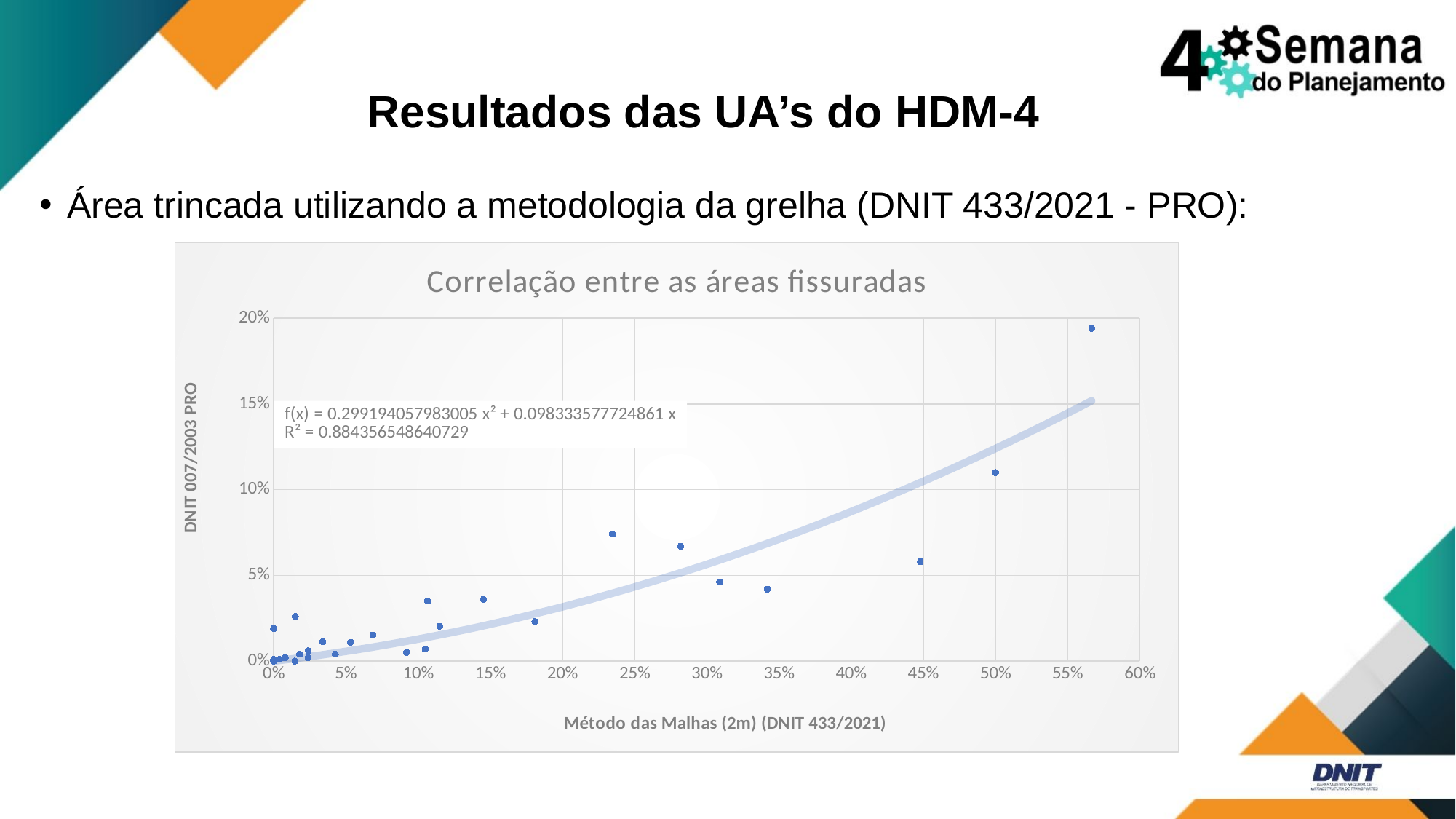
What is the title of the chart? Correlação entre as áreas fissuradas What is the coefficient of x in the trendline equation printed on the chart? 0.098333577724861 Is the y value of the highest plotted point greater or less than 15%? greater Do the plotted values generally rise or fall as the x-axis value increases? Rise What is the highest tick value shown on the y axis? 20% Is the y value of the point plotted at about 50% on the x axis greater or less than 10%? greater What kind of chart is shown on the slide? Scatter chart What R² value is printed on the chart for the trendline? 0.884356548640729 What is the coefficient of x² in the trendline equation printed on the chart? 0.299194057983005 Is the x value of the highest plotted point greater or less than 55%? greater What is the label of the x axis of the chart? Método das Malhas (2m) (DNIT 433/2021)